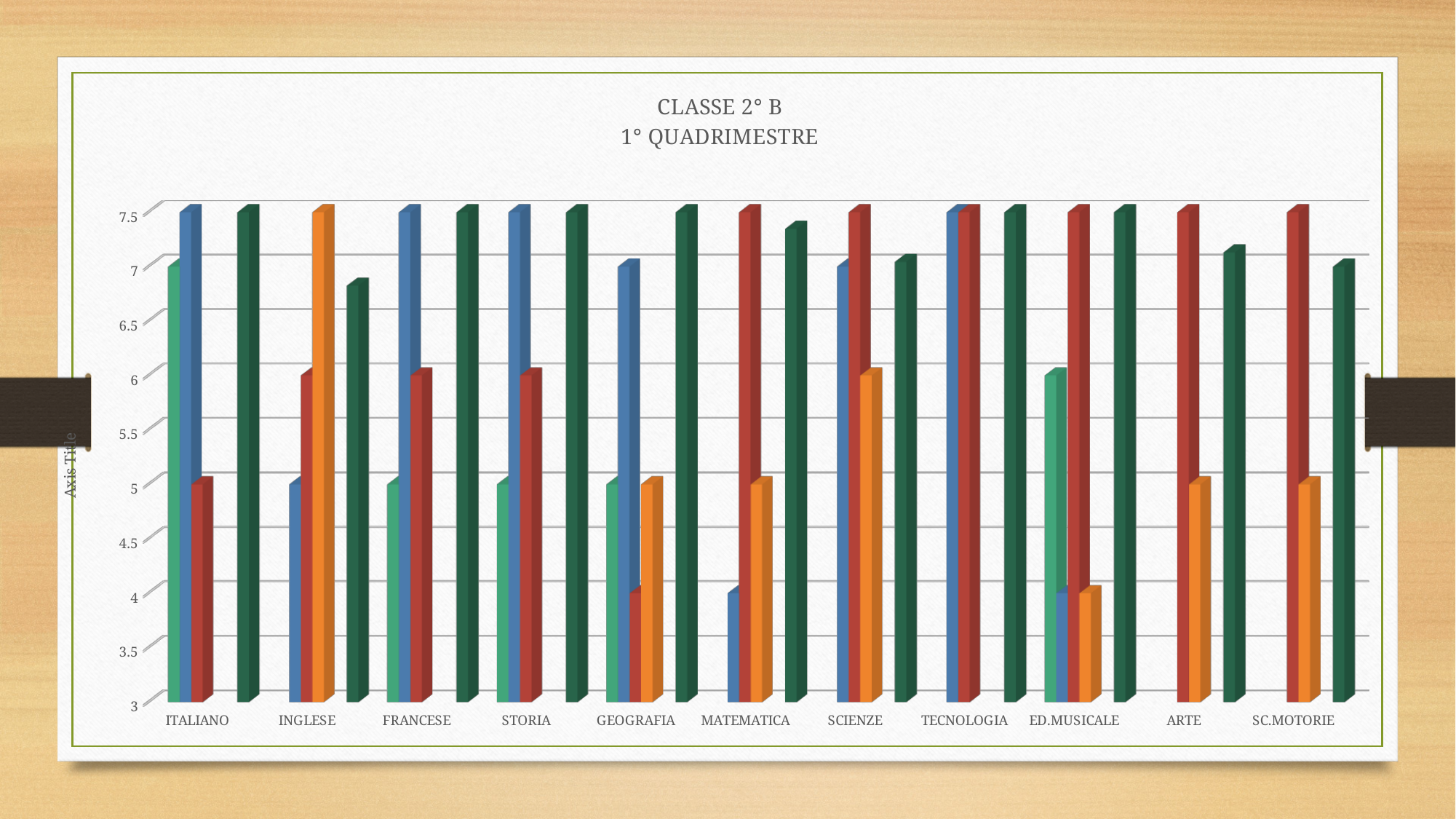
How many subject categories are shown along the x axis? 11 What kind of chart is shown on the slide? bar chart What is the title of the chart? CLASSE 2° B 1° QUADRIMESTRE What is the label shown on the vertical axis? Axis Title Is the rightmost (dark green) bar for MATEMATICA greater or less than 7? greater How many bars are plotted for the TECNOLOGIA category? 3 Which category is listed last on the x axis? SC.MOTORIE Is the rightmost (dark green) bar for ARTE greater or less than 7? greater Is the rightmost (dark green) bar for INGLESE greater or less than 7? less